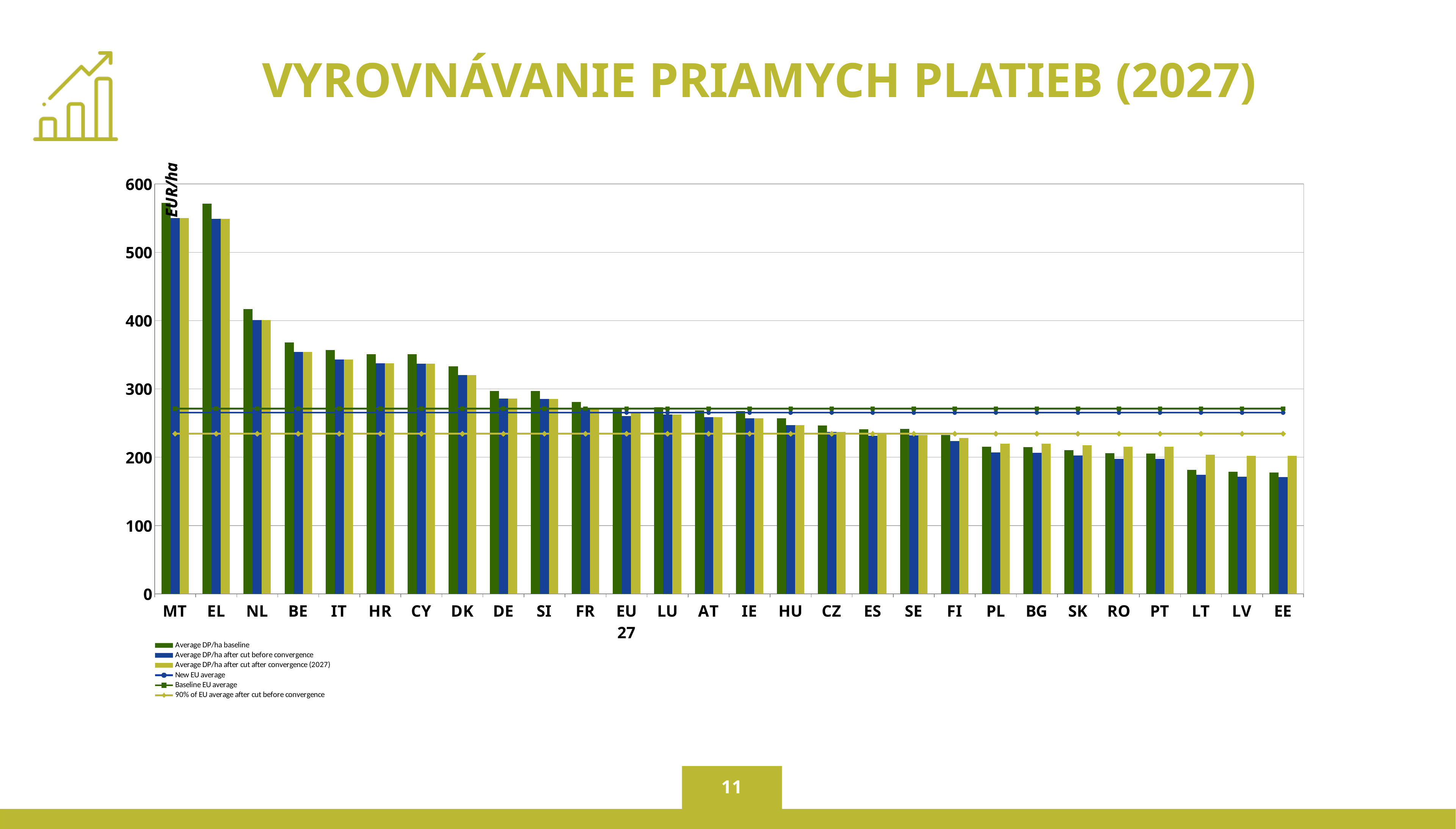
Which has the larger Average DP/ha baseline value, CY or DE? CY Is the Average DP/ha baseline value for NL greater or less than 400? greater Do the Average DP/ha baseline values rise or fall moving from left to right along the x axis? fall Is the Average DP/ha baseline value for MT greater or less than 500? greater Which has the larger Average DP/ha baseline value, NL or BE? NL Is the Average DP/ha baseline value for BE greater or less than 400? less What unit is shown on the y axis of the chart? EUR/ha What kind of chart is shown on the slide? combination bar and line chart How many countries/categories are shown on the x axis of the chart? 28 How many series does the chart's legend list? 6